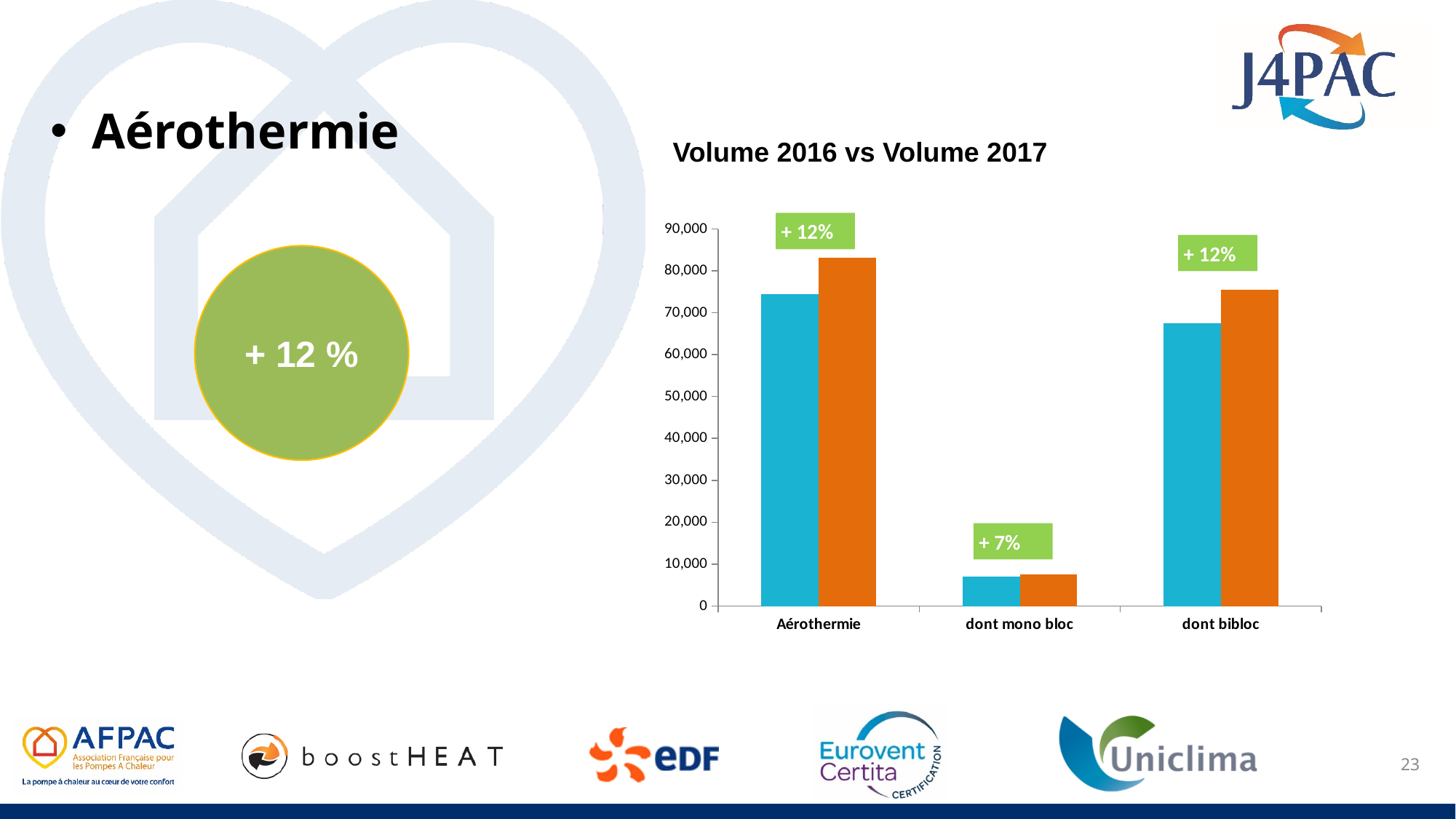
Is the value of the blue bar for 'dont mono bloc' greater or less than 10,000? less What growth percentage is labelled above the bars for 'Aérothermie'? + 12% How many categories are shown on the x axis of the chart? 3 For 'Aérothermie', which bar is taller, the blue bar or the orange bar? the orange bar Which category has the lowest bars in the chart? dont mono bloc What growth percentage is labelled above the bars for 'dont bibloc'? + 12% Which category has the highest bars in the chart? Aérothermie What kind of chart is shown on the slide? bar chart Is the value of the orange bar for 'Aérothermie' greater or less than 80,000? greater What is the title of the chart? Volume 2016 vs Volume 2017 What growth percentage is labelled above the bars for 'dont mono bloc'? + 7% Is the value of the blue bar for 'dont bibloc' greater or less than 70,000? less